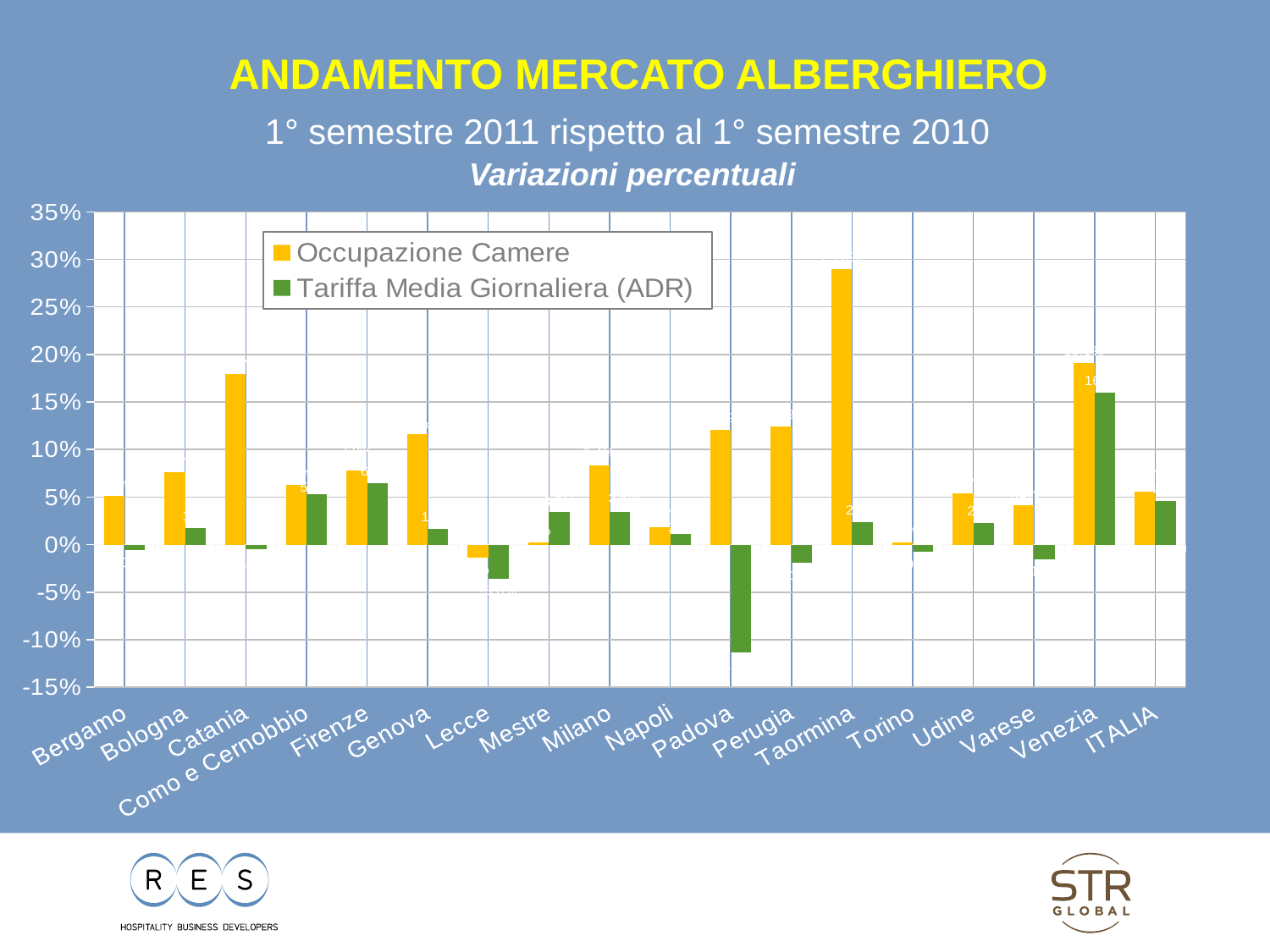
Which category has the lowest value for Tariffa Media Giornaliera (ADR)? Padova How many categories are shown on the x axis? 18 Is the Tariffa Media Giornaliera (ADR) value for Padova greater or less than -10%? less What kind of chart is shown on the slide? bar chart Which category has the highest value for Tariffa Media Giornaliera (ADR)? Venezia What colour are the bars for Tariffa Media Giornaliera (ADR)? green Is the Occupazione Camere value for Catania greater or less than 15%? greater Which category has the lowest value for Occupazione Camere? Lecce Is the Occupazione Camere value for Taormina greater or less than 25%? greater How many series does the legend list? 2 Which category has the highest value for Occupazione Camere? Taormina Which is larger, the Occupazione Camere value for Catania or for Bologna? Catania